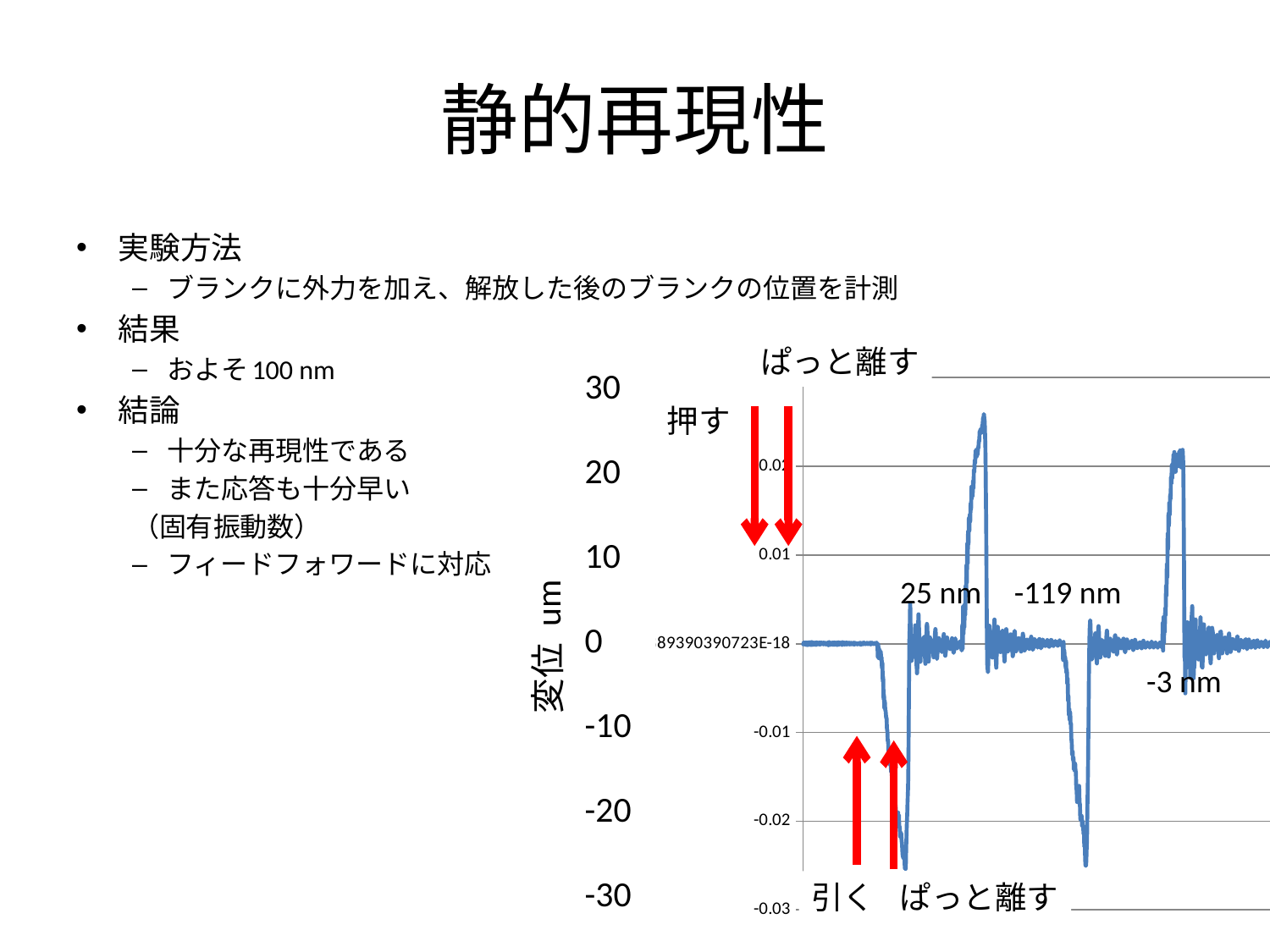
What is the first residual displacement value annotated on the chart, after the first release? 25 nm Is the lowest trough of the line greater or less than -20 on the large vertical axis scale? less What is the residual displacement value annotated after the third release on the chart? -3 nm What is the difference between the annotated values 25 nm and -119 nm? 144 nm What kind of chart is shown on the slide? line chart How many residual displacement values are annotated on the chart? 3 What is the label on the vertical axis of the chart? 変位 um Is the annotated value 25 nm larger than the annotated value -3 nm? Yes Is the highest peak of the line greater or less than 20 on the large vertical axis scale? greater Which annotated residual displacement has the largest magnitude? -119 nm Which annotated residual displacement has the smallest magnitude? -3 nm What is the residual displacement value annotated after the second release on the chart? -119 nm